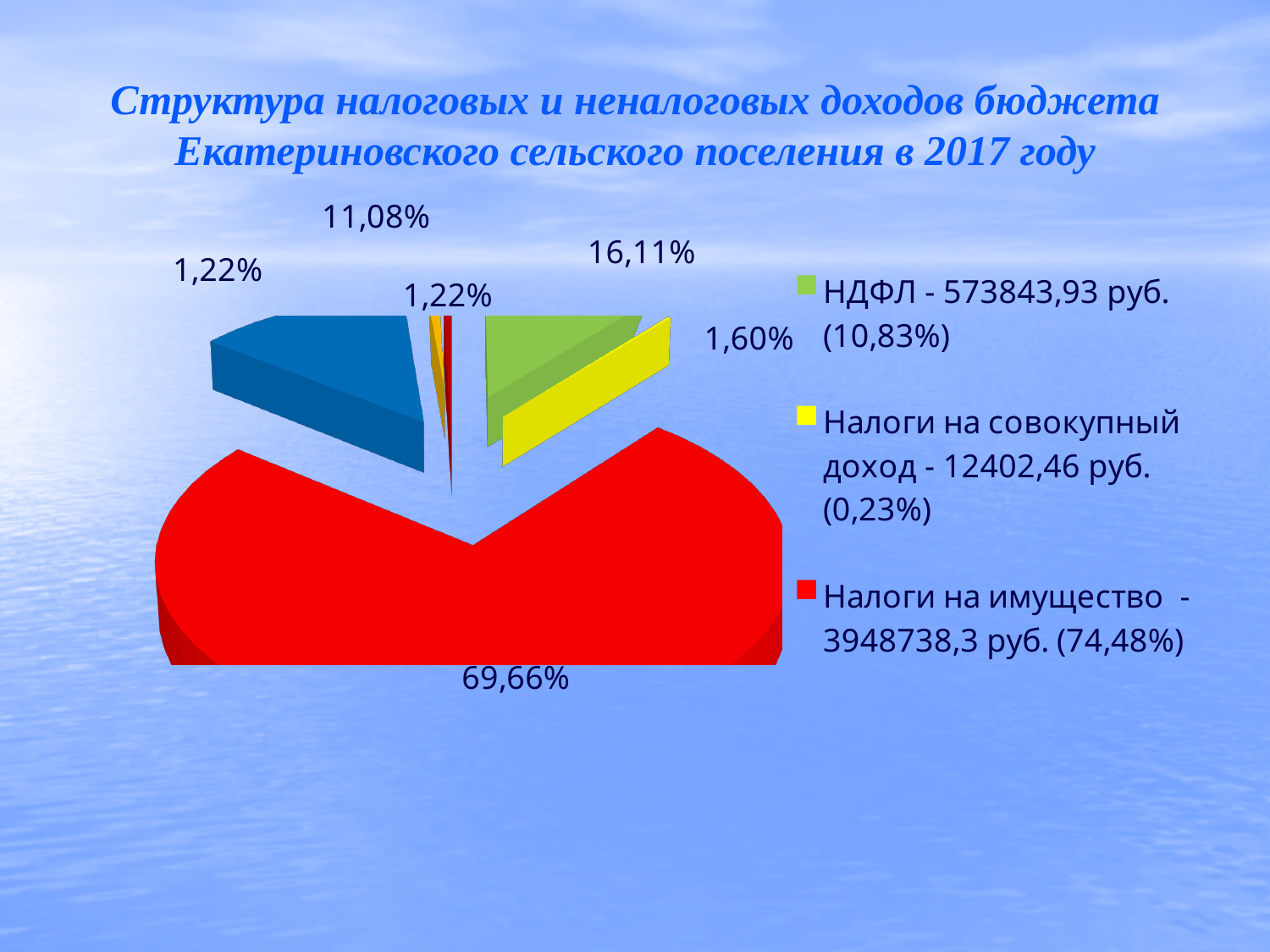
What is the difference between the slices labelled 16,11% and 11,08%? 5,03% Which legend entry is shown in red? Налоги на имущество What kind of chart is shown on the slide? pie chart According to the legend, what amount in rubles is given for Налоги на имущество? 3948738,3 руб. According to the legend, what amount in rubles is given for НДФЛ? 573843,93 руб. How many slices does the pie chart have? 6 What share of the pie does the large red slice represent? 69,66% What is the smallest percentage labelled on the pie chart? 1,22% Is the share of the large red slice greater or less than 50%? greater What is the largest percentage labelled on the pie chart? 69,66% How many entries are listed in the chart legend? 3 Which is larger, the slice labelled 16,11% or the slice labelled 11,08%? 16,11%